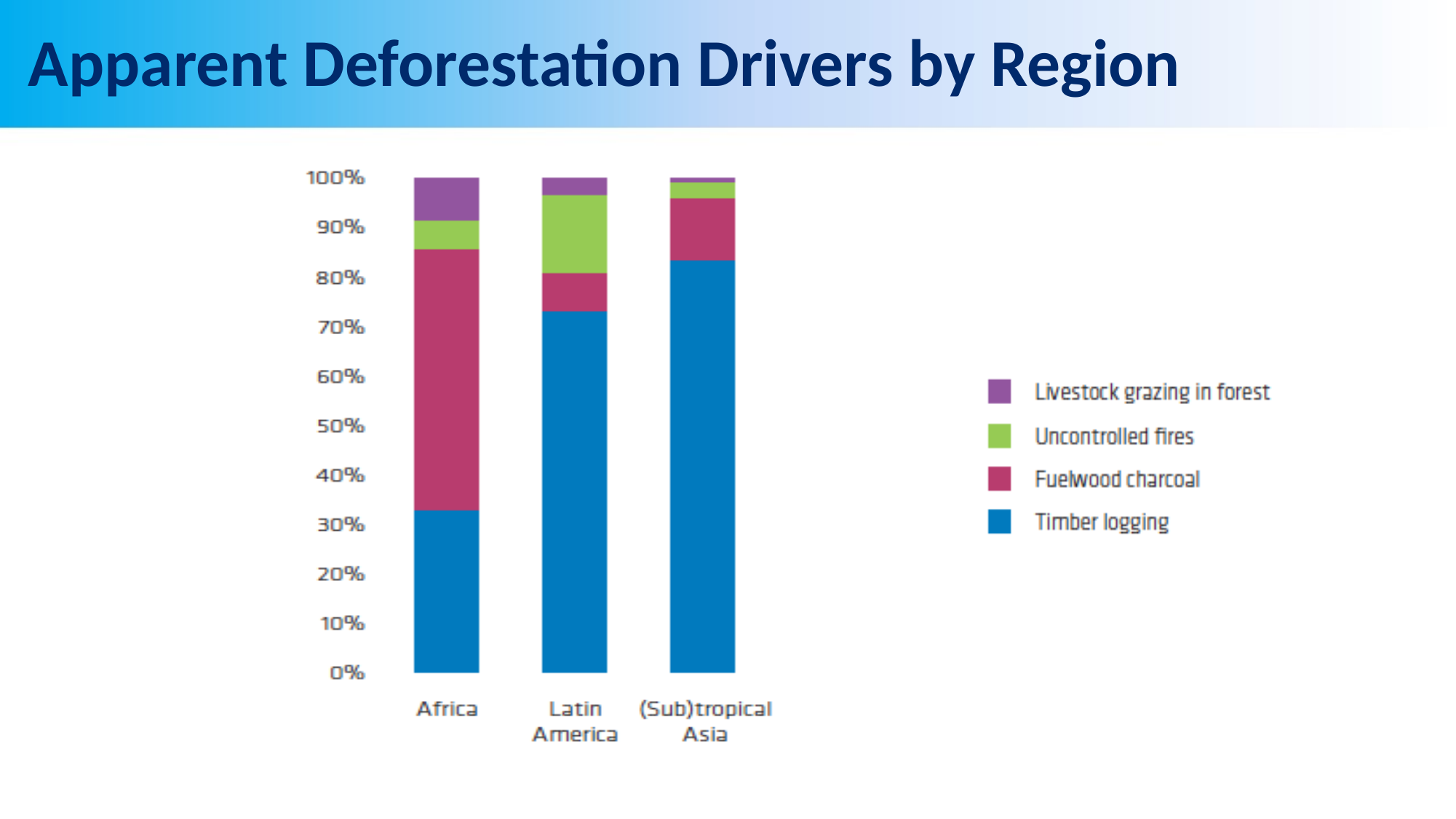
Which region has the largest Fuelwood charcoal share? Africa Which region has the largest Uncontrolled fires share? Latin America What is the title of the slide? Apparent Deforestation Drivers by Region Which region has the smallest Livestock grazing in forest share? (Sub)tropical Asia Is the Timber logging share for Latin America greater or less than 70%? greater How many regions are shown on the x axis? 3 Is the Timber logging share for (Sub)tropical Asia greater or less than 80%? greater Which driver is shown in blue in the legend? Timber logging What kind of chart is shown on the slide? Stacked bar chart Is the Timber logging share for Africa greater or less than 40%? less Which region has the largest Timber logging share? (Sub)tropical Asia How many series does the legend list? 4